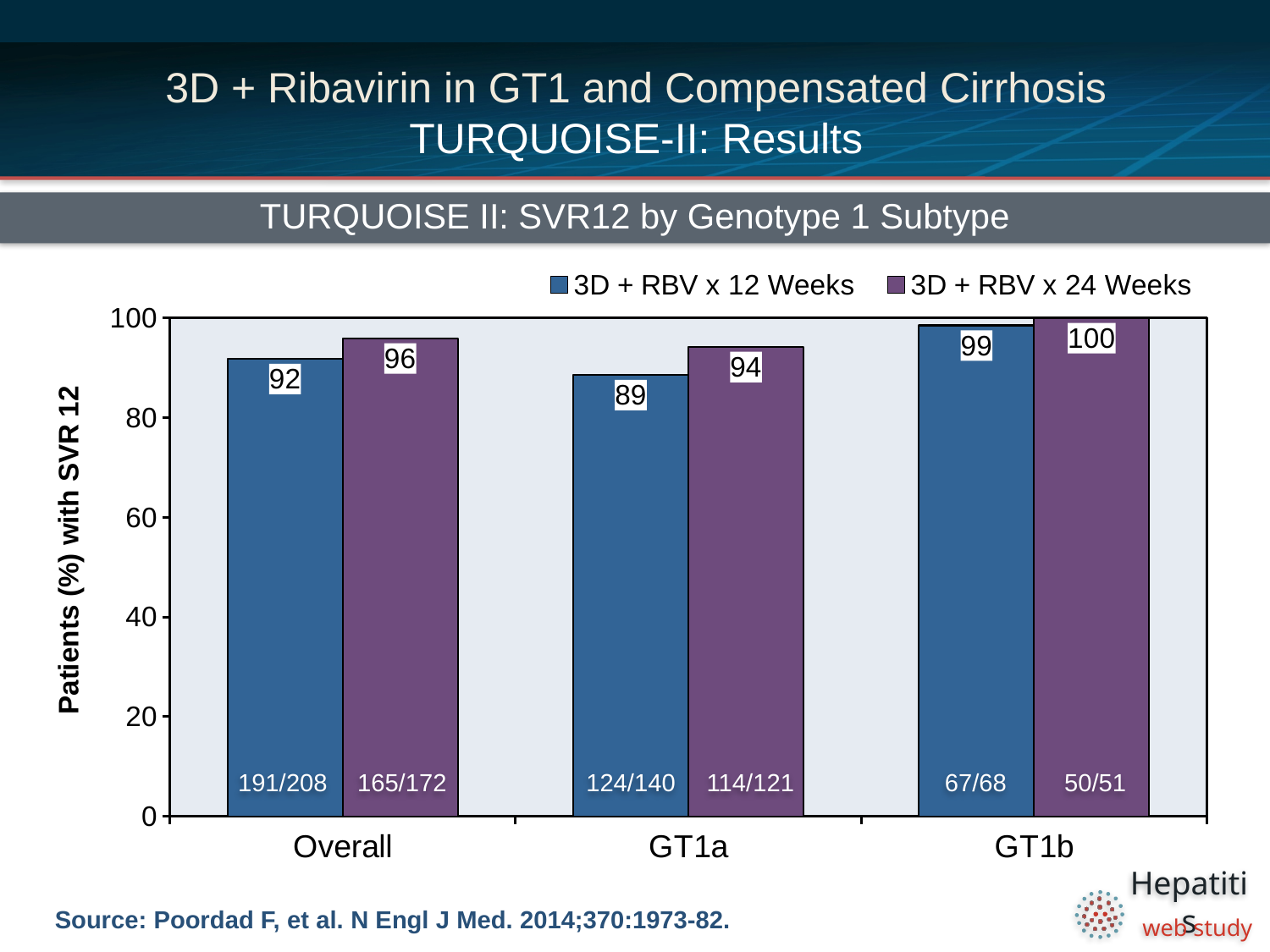
How many genotype categories are shown on the x axis? 3 What is the difference between the 24-week and 12-week SVR12 rates in the GT1a group? 5 How many series does the legend list? 2 What is the SVR12 rate for 3D + RBV x 12 Weeks in the Overall group? 92 What kind of chart is shown on the slide? Bar chart What is the label of the y axis? Patients (%) with SVR 12 Which genotype group has the highest SVR12 rate for 3D + RBV x 24 Weeks? GT1b What is the SVR12 rate for 3D + RBV x 24 Weeks in the GT1a group? 94 What fraction of patients is shown for 3D + RBV x 24 Weeks in the Overall group? 165/172 What is the SVR12 rate for 3D + RBV x 12 Weeks in the GT1b group? 99 In the Overall group, which regimen has the higher SVR12 rate, 12 weeks or 24 weeks? 3D + RBV x 24 Weeks Which genotype group has the lowest SVR12 rate for 3D + RBV x 12 Weeks? GT1a